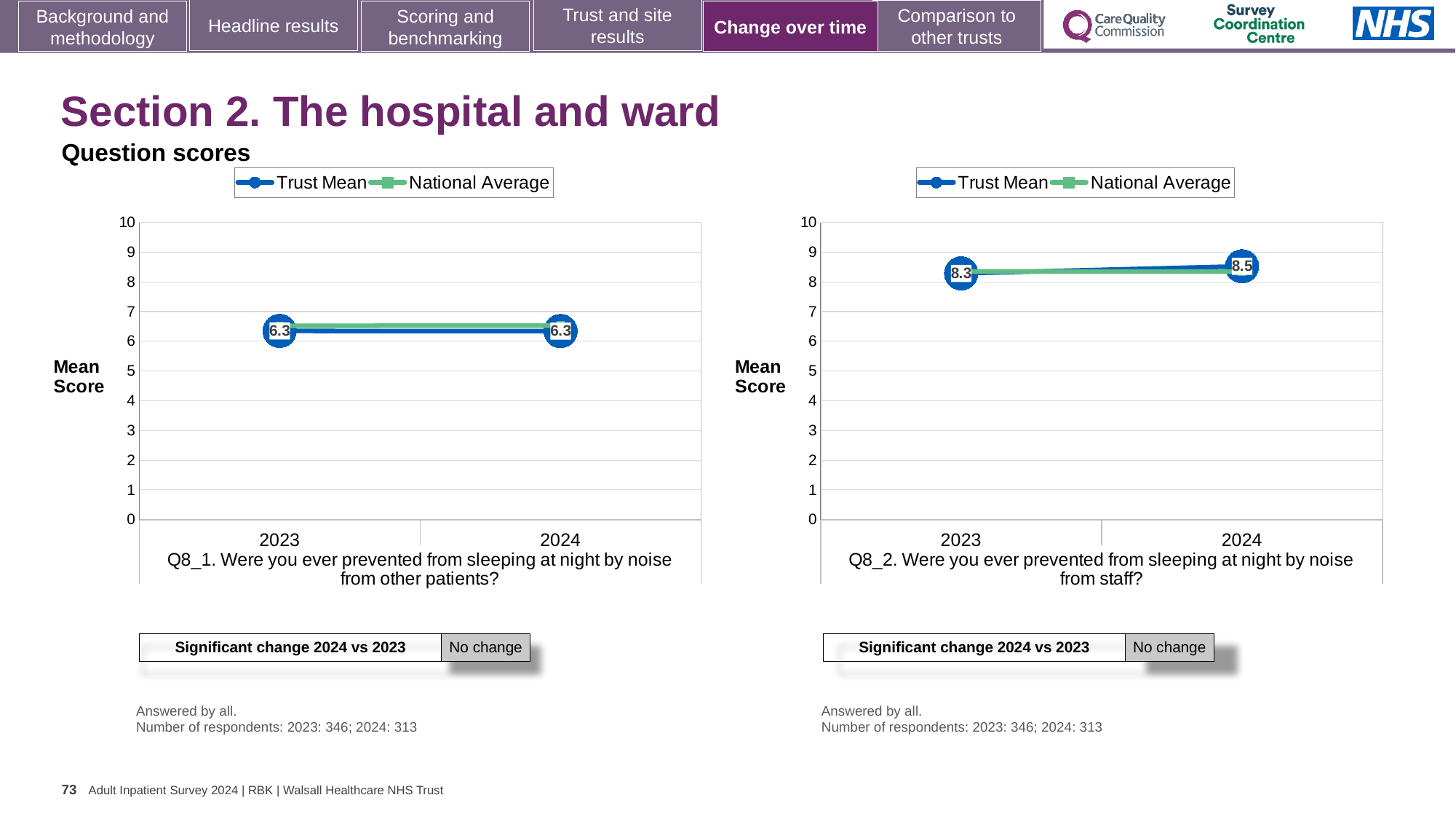
On the Q8_1 chart (left), does the Trust Mean rise, fall or stay the same from 2023 to 2024? Stays the same On the Q8_2 chart (right), what is the Trust Mean score for 2023? 8.3 On the Q8_2 chart (right), what is the difference between the Trust Mean scores for 2024 and 2023? 0.2 On the Q8_1 chart (left), is the Trust Mean for 2023 greater or less than 7? less On the Q8_2 chart (right), does the Trust Mean rise or fall from 2023 to 2024? Rise On the Q8_2 chart (right), what is the Trust Mean score for 2024? 8.5 On the Q8_1 chart (left), what is the Trust Mean score for 2023? 6.3 On the Q8_1 chart (left), what is the Trust Mean score for 2024? 6.3 How many series does the legend of the Q8_1 chart (left) list? 2 On the Q8_2 chart (right), which year has the higher Trust Mean score, 2023 or 2024? 2024 What kind of chart is the Q8_2 chart (right)? Line chart On the Q8_2 chart (right), is the Trust Mean for 2024 greater or less than 8? greater